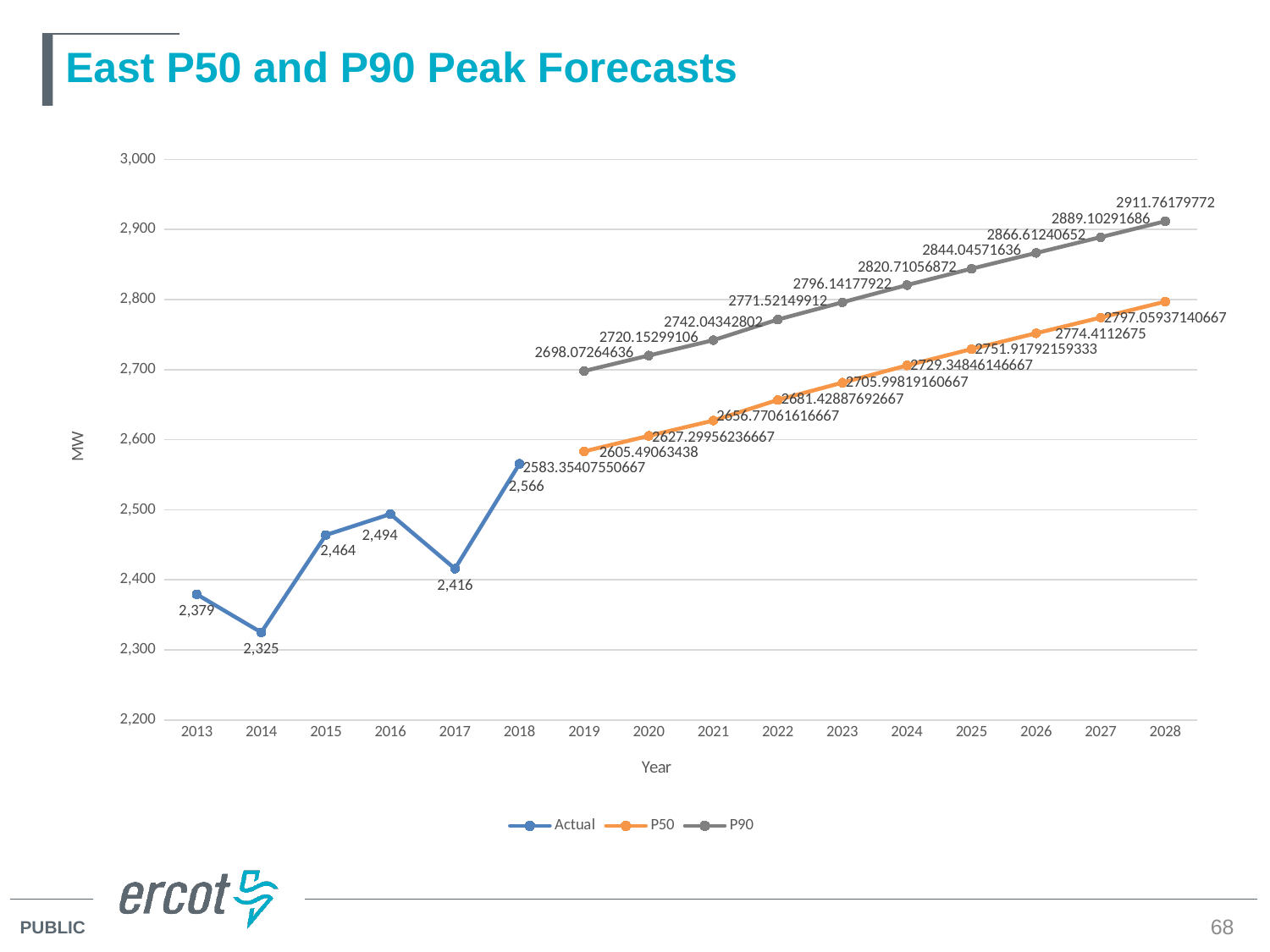
How many series does the legend list? 3 Is the P90 value for 2024 greater or less than 2,800? greater What is the P50 value for 2028? 2797.05937140667 What is the P90 value for 2028? 2911.76179772 In which year is the Actual series highest? 2018 In which year is the Actual series lowest? 2014 How many years are shown on the x axis? 16 What is the Actual value for 2014? 2,325 What kind of chart is shown on the slide? line chart What is the difference between the Actual values for 2018 and 2013? 187 Does the P90 series rise or fall from 2019 to 2028? rise Which year has the larger Actual value, 2016 or 2017? 2016